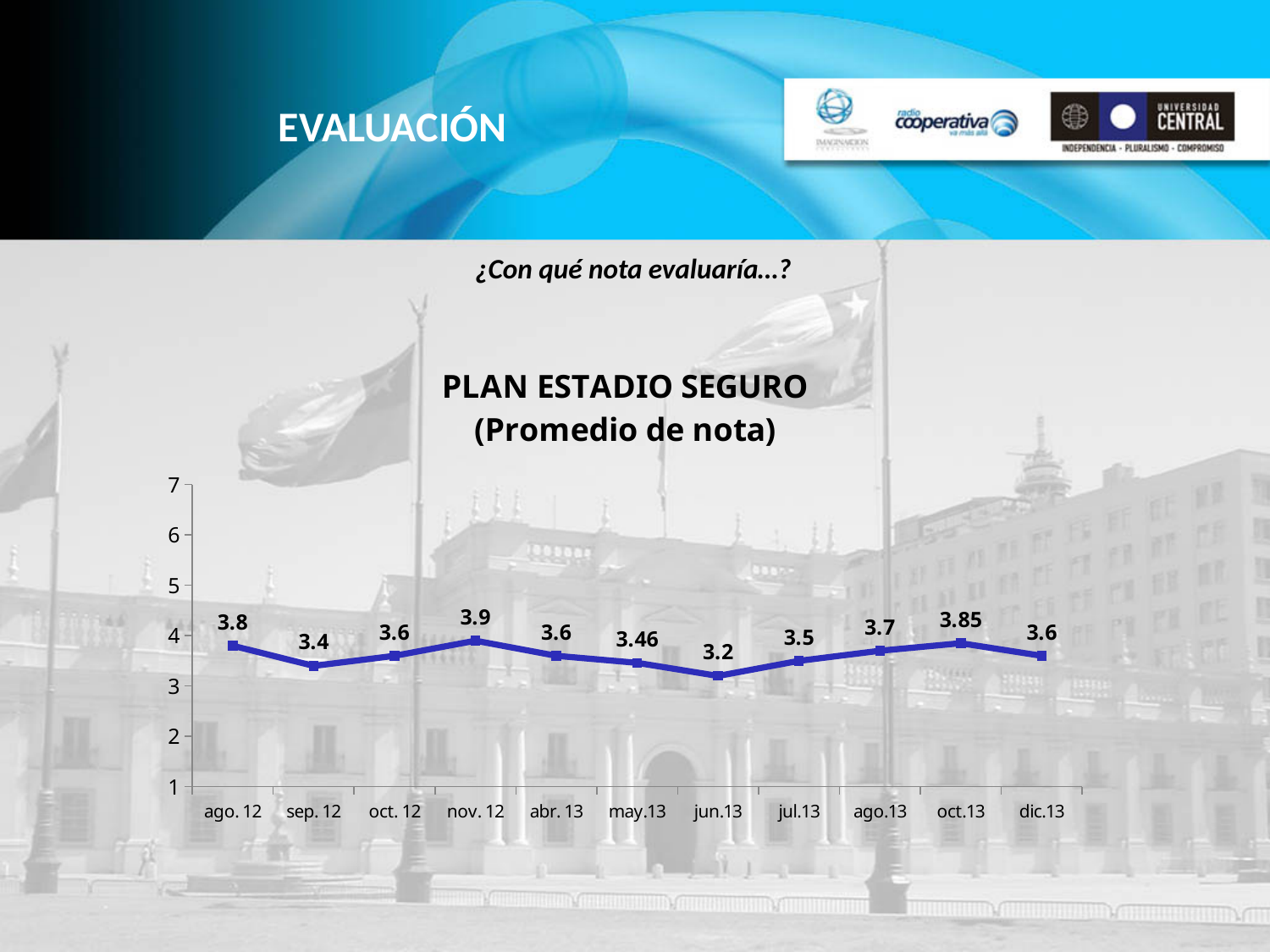
What is the difference between the values for ago. 12 and sep. 12? 0.4 What is the value for may.13? 3.46 Which period has the lowest value? jun.13 How many data points are plotted on the chart? 11 What is the difference between the values for nov. 12 and jun.13? 0.7 Which is larger, the value for ago.13 or the value for jul.13? ago.13 What type of chart is shown on the slide? line chart What is the value for jun.13? 3.2 What is the value for oct.13? 3.85 What is the value for nov. 12? 3.9 What is the title of the chart? PLAN ESTADIO SEGURO (Promedio de nota) Which period has the highest value? nov. 12